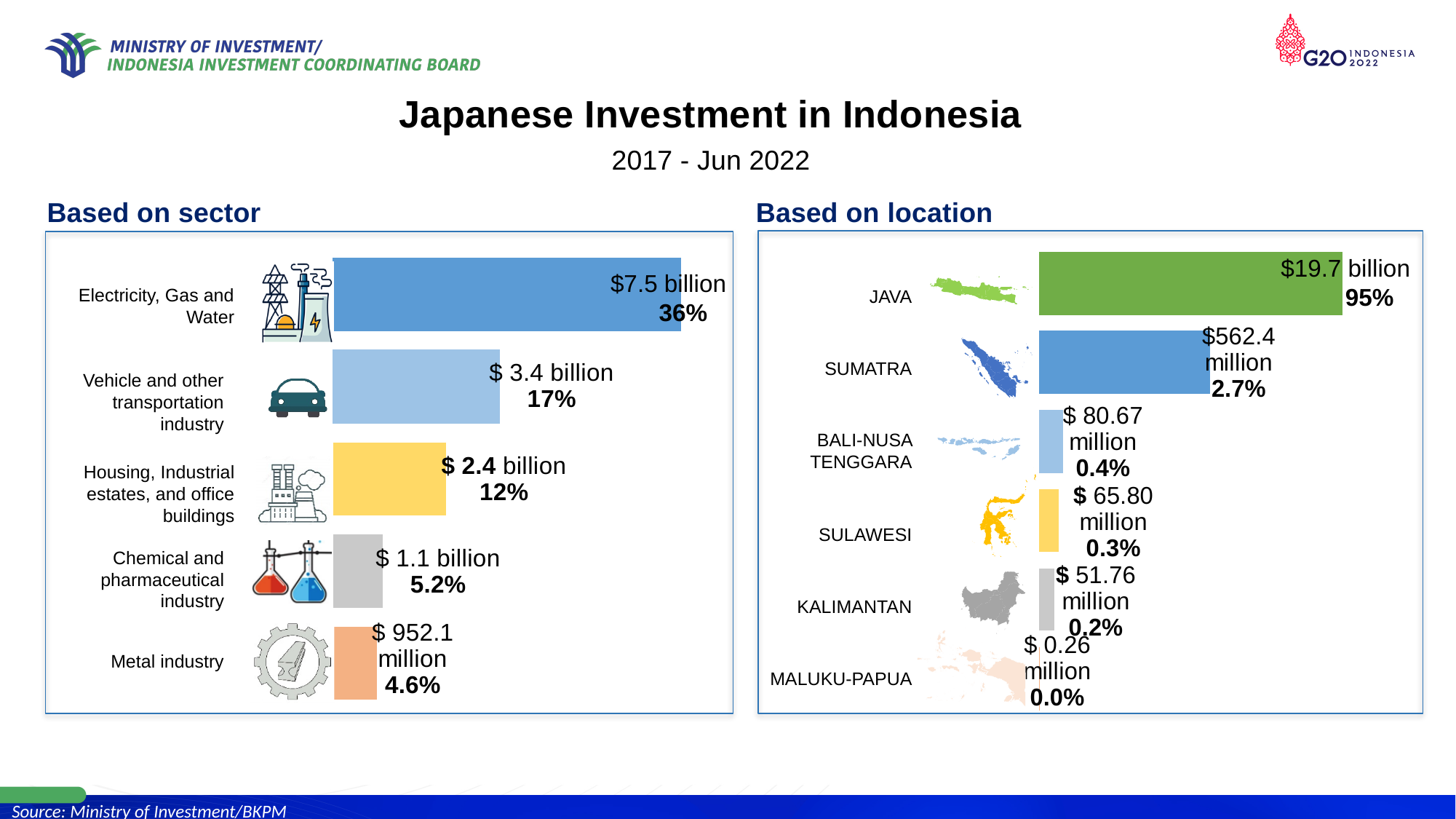
In the 'Based on sector' chart, what is the investment value for the Chemical and pharmaceutical industry? $ 1.1 billion In the 'Based on sector' chart, what percentage share is shown for the Vehicle and other transportation industry? 17% What type of chart is the 'Based on location' chart? Bar chart In the 'Based on sector' chart, what is the investment value for Electricity, Gas and Water? $7.5 billion In the 'Based on location' chart, which is larger, the investment in Sulawesi or in Kalimantan? Sulawesi In the 'Based on sector' chart, what is the difference in percentage share between Electricity, Gas and Water and the Vehicle and other transportation industry? 19 percentage points In the 'Based on sector' chart, which sector has the lowest investment value? Metal industry In the 'Based on location' chart, how many locations are shown? 6 In the 'Based on location' chart, what percentage share is shown for Sumatra? 2.7% In the 'Based on location' chart, what is the investment value for Java? $19.7 billion In the 'Based on sector' chart, how many sectors are shown? 5 In the 'Based on location' chart, which location has the highest investment value? Java